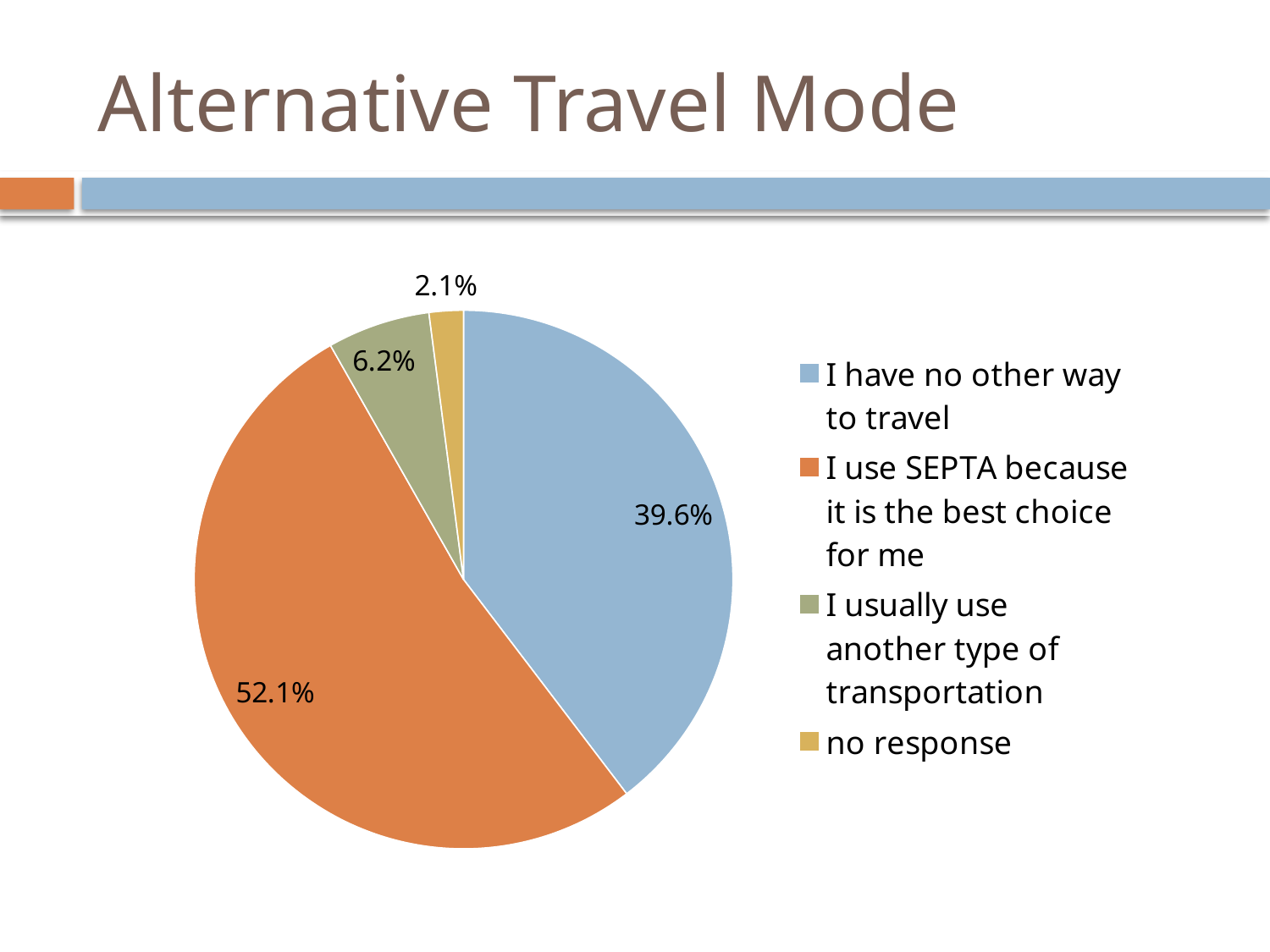
Which category has the largest share of the pie? I use SEPTA because it is the best choice for me Which is larger: the share for "I have no other way to travel" or the share for "I usually use another type of transportation"? I have no other way to travel Which category has the smallest share of the pie? no response What colour is the slice for "no response"? yellow What percentage of respondents said "I usually use another type of transportation"? 6.2% How many categories does the pie chart show? 4 What percentage of respondents gave no response? 2.1% What percentage of respondents said "I use SEPTA because it is the best choice for me"? 52.1% What is the title of the slide containing the pie chart? Alternative Travel Mode What is the difference in percentage points between "I use SEPTA because it is the best choice for me" and "I have no other way to travel"? 12.5 What kind of chart is shown on the slide? pie chart What percentage of respondents said "I have no other way to travel"? 39.6%